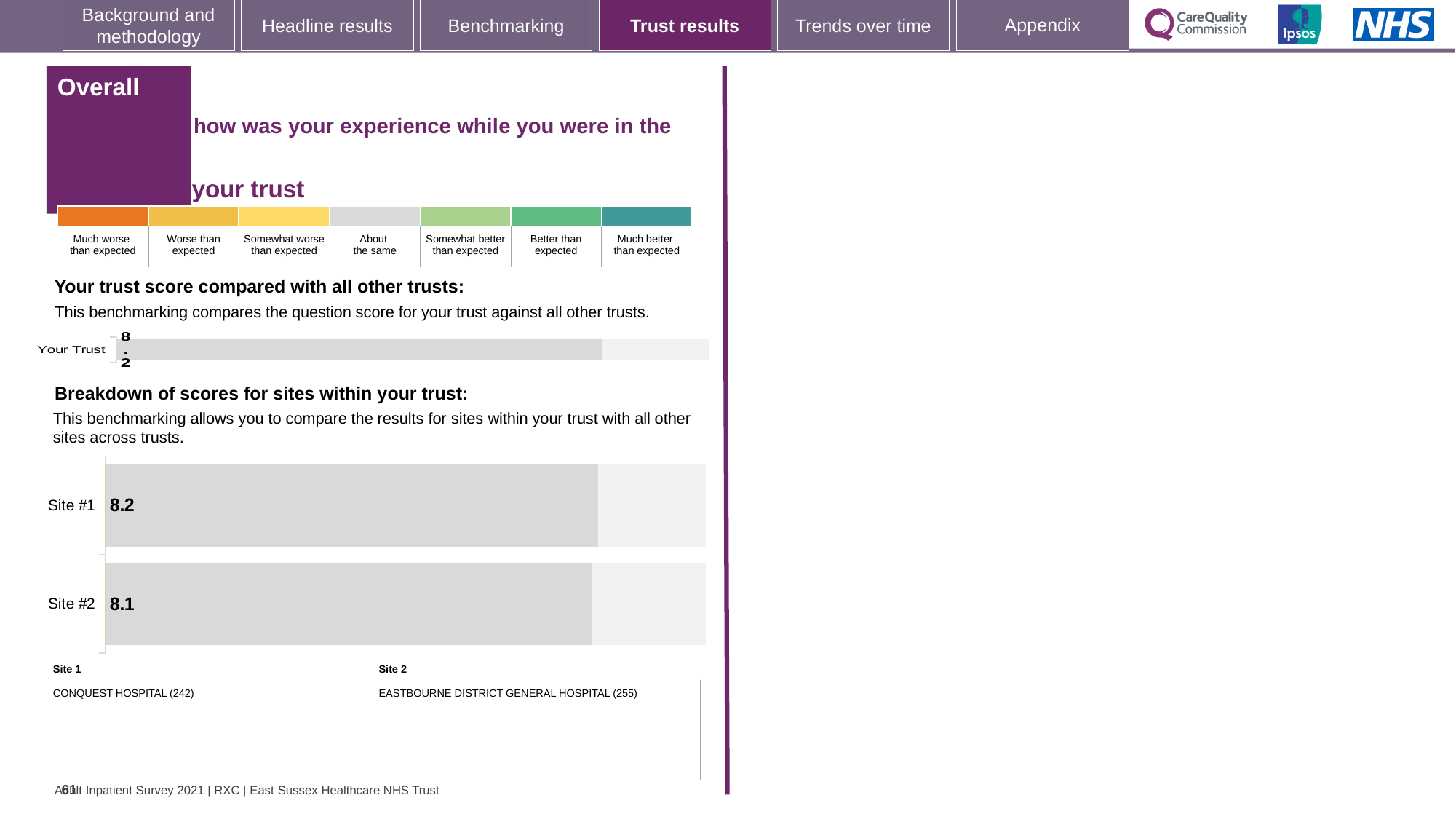
What kind of chart is the 'Breakdown of scores for sites within your trust' chart? Bar chart In the 'Your trust score compared with all other trusts' chart, what is the score for Your Trust? 8.2 According to the site key below the charts, which hospital is Site 2? EASTBOURNE DISTRICT GENERAL HOSPITAL (255) How many categories are plotted in the 'Your trust score compared with all other trusts' chart? 1 How many sites are shown in the 'Breakdown of scores for sites within your trust' chart? 2 In the 'Breakdown of scores for sites within your trust' chart, which site has the highest score? Site #1 In the 'Breakdown of scores for sites within your trust' chart, what is the score for Site #1? 8.2 In the 'Breakdown of scores for sites within your trust' chart, which site has the lowest score? Site #2 In the 'Breakdown of scores for sites within your trust' chart, which has the larger score, Site #1 or Site #2? Site #1 According to the site key below the charts, which hospital is Site 1? CONQUEST HOSPITAL (242) In the 'Breakdown of scores for sites within your trust' chart, what is the score for Site #2? 8.1 In the 'Breakdown of scores for sites within your trust' chart, what is the difference between the scores for Site #1 and Site #2? 0.1